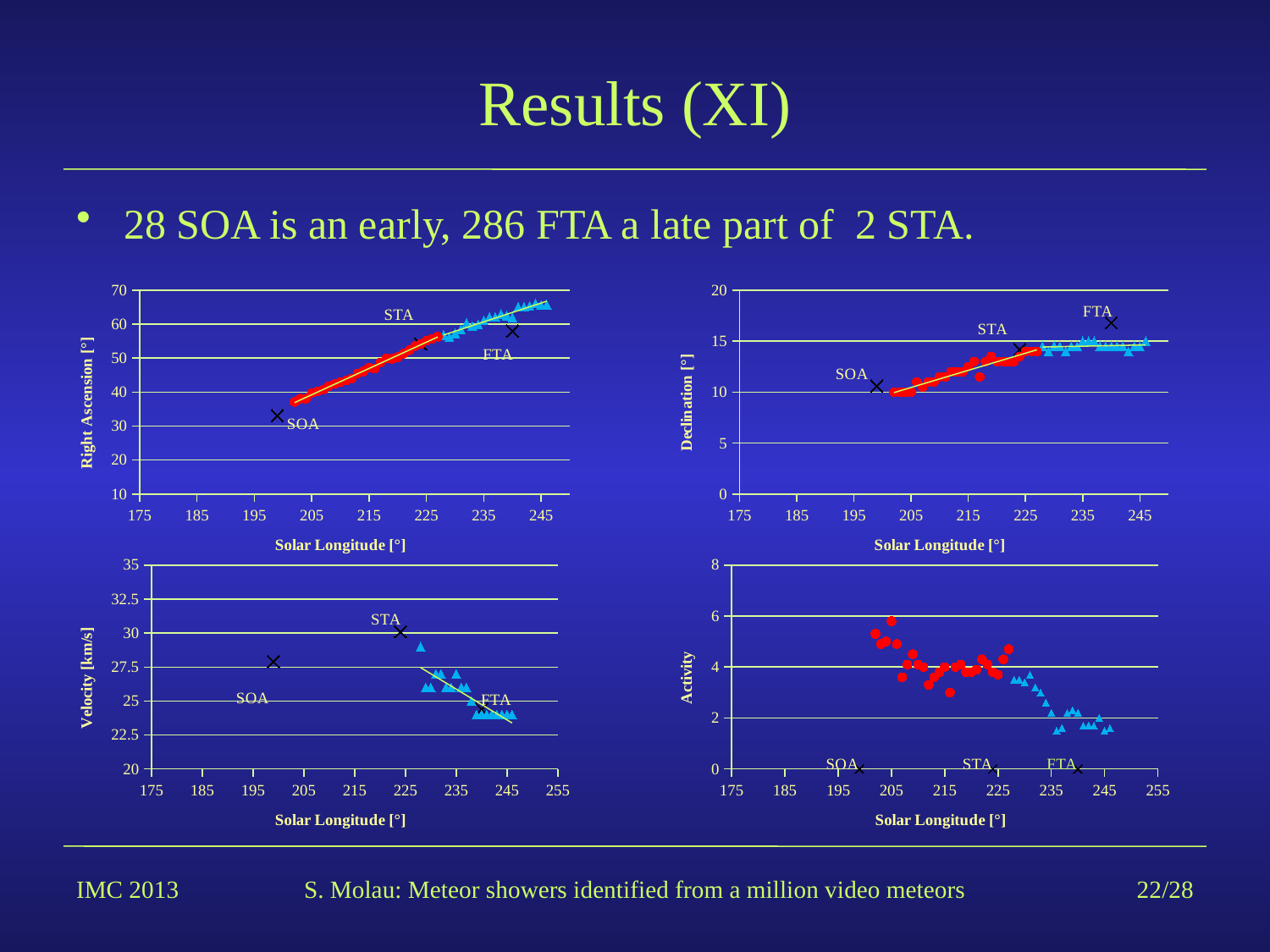
In the Declination chart (top right), do the plotted values rise or fall as solar longitude increases? rise In the Declination chart (top right), is the value at the FTA marker greater or less than 15? greater In the Velocity chart (bottom left), is the value at the SOA marker greater or less than 25? greater In the Right Ascension chart (top left), do the plotted values rise or fall as solar longitude increases? rise In the Right Ascension chart (top left), is the value at the SOA marker greater or less than 40? less How many charts are shown on the slide? 4 In the Activity chart (bottom right), do the plotted values rise or fall as solar longitude increases? fall What kind of chart is the Right Ascension chart in the top left? scatter chart What is the x-axis title shared by all four charts? Solar Longitude [°]